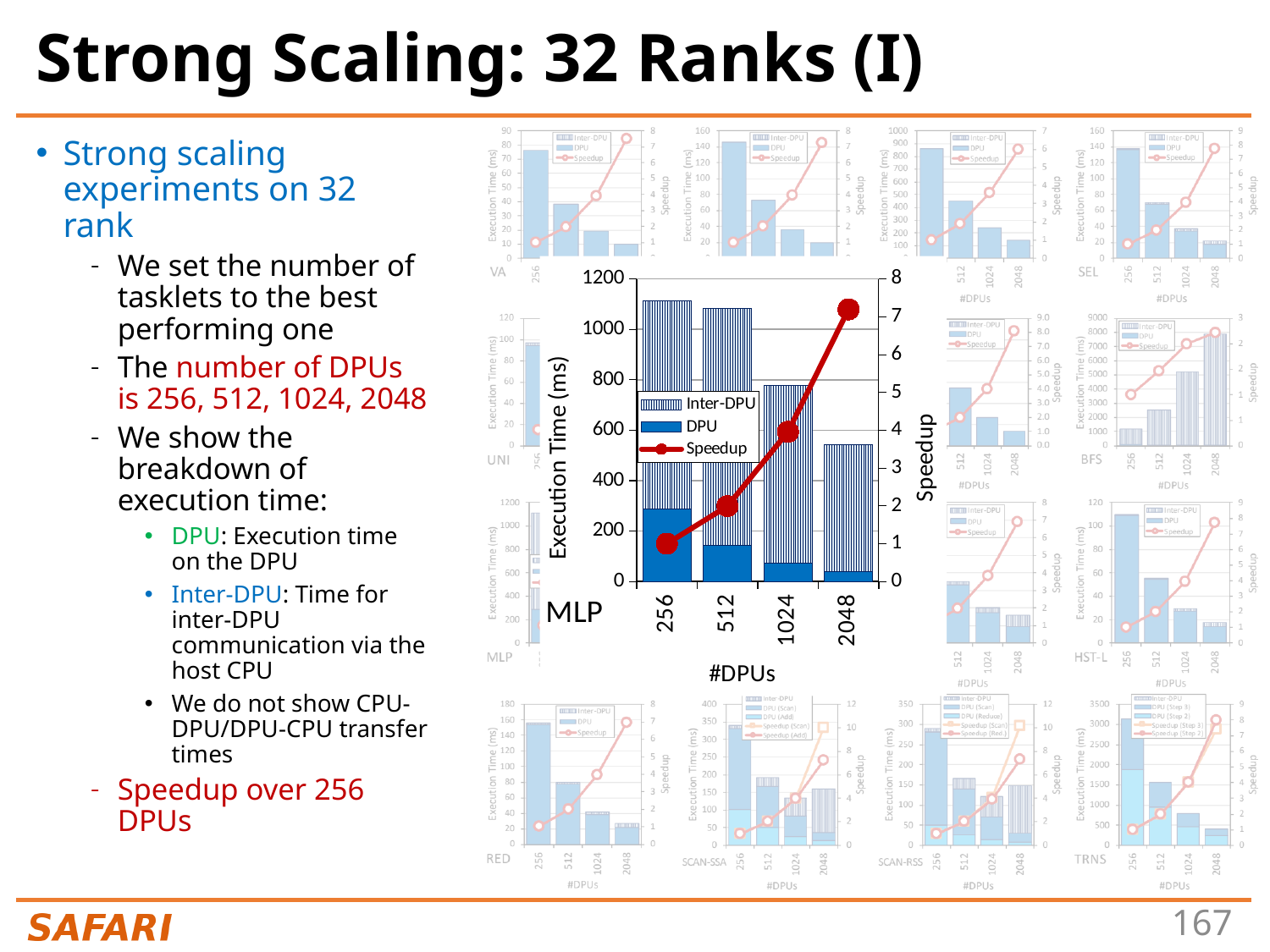
In the large MLP chart, is the total execution time for 2048 DPUs greater or less than 600 ms? less In the large MLP chart, is the total execution time for 256 DPUs greater or less than 1000 ms? greater In the large MLP chart, which #DPUs value has the lowest total execution time? 2048 In the large MLP chart, is the Speedup for 512 DPUs larger or smaller than the Speedup for 1024 DPUs? Smaller What is the label of the left vertical axis of the large MLP chart? Execution Time (ms) In the large MLP chart, is the Speedup for 2048 DPUs greater or less than 6? greater In the large MLP chart, does the Speedup line rise or fall as #DPUs increases from 256 to 2048? Rises What kind of chart is the large MLP chart? Stacked bar chart with a line In the large MLP chart, which #DPUs value has the largest DPU portion of execution time? 256 In the large MLP chart, how many #DPUs categories are shown on the x axis? 4 In the large MLP chart, how many series does the legend list? 3 In the large MLP chart, does the total execution time rise or fall as #DPUs increases from 256 to 2048? Falls